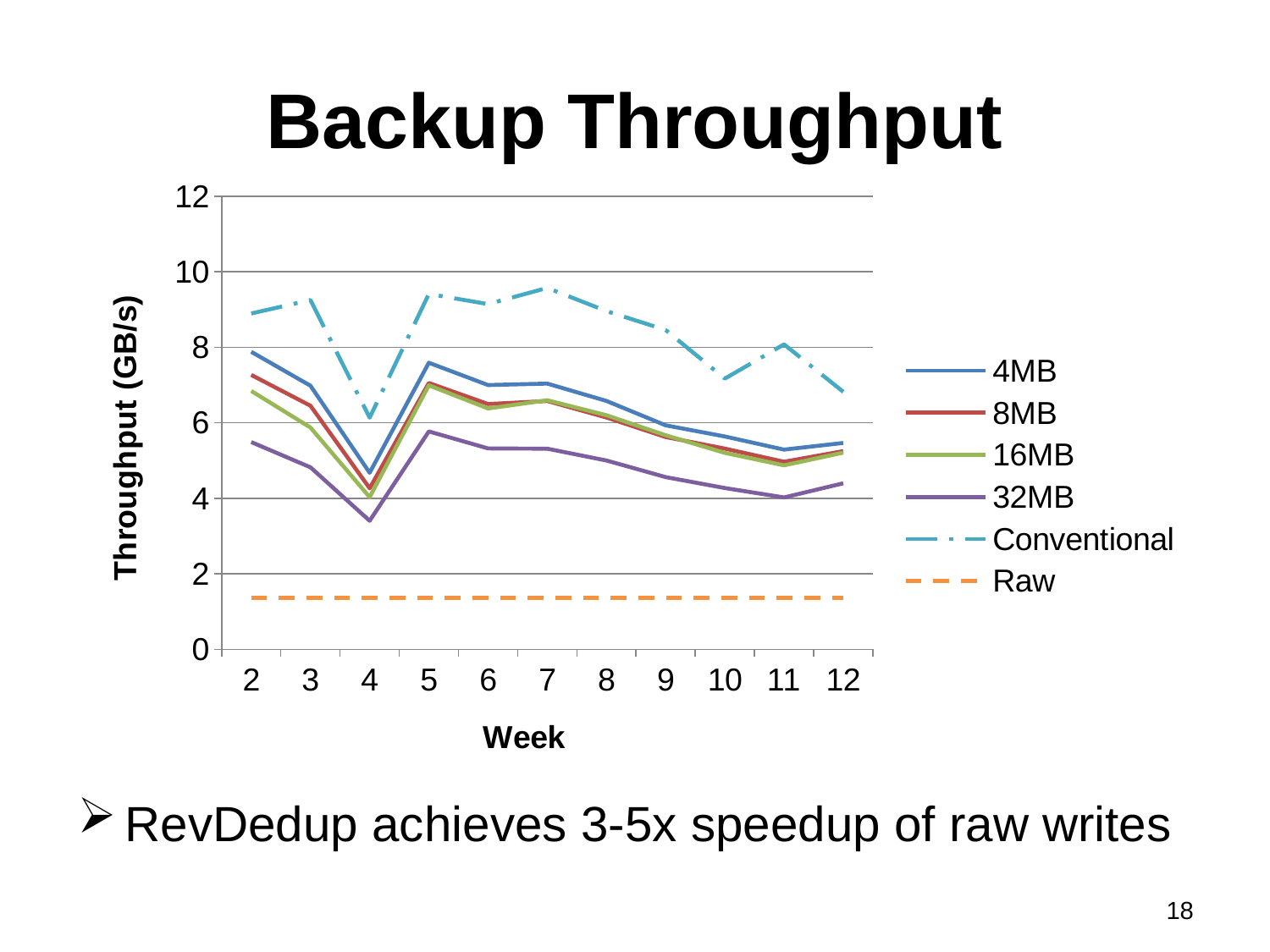
Does the 32MB series rise or fall from week 5 to week 11? fall Is the 32MB value at week 4 greater or less than 4? less Is the 4MB value at week 5 greater or less than 6? greater How many weeks are plotted along the x axis? 11 What kind of chart is shown on the slide? line chart How many series does the legend list? 6 In which week does the 4MB series reach its lowest value? 4 What is the label of the y axis? Throughput (GB/s) Is the Conventional value at week 7 greater or less than 8? greater Which series has the highest throughput at week 2? Conventional At week 4, which series has the higher throughput, 4MB or 32MB? 4MB